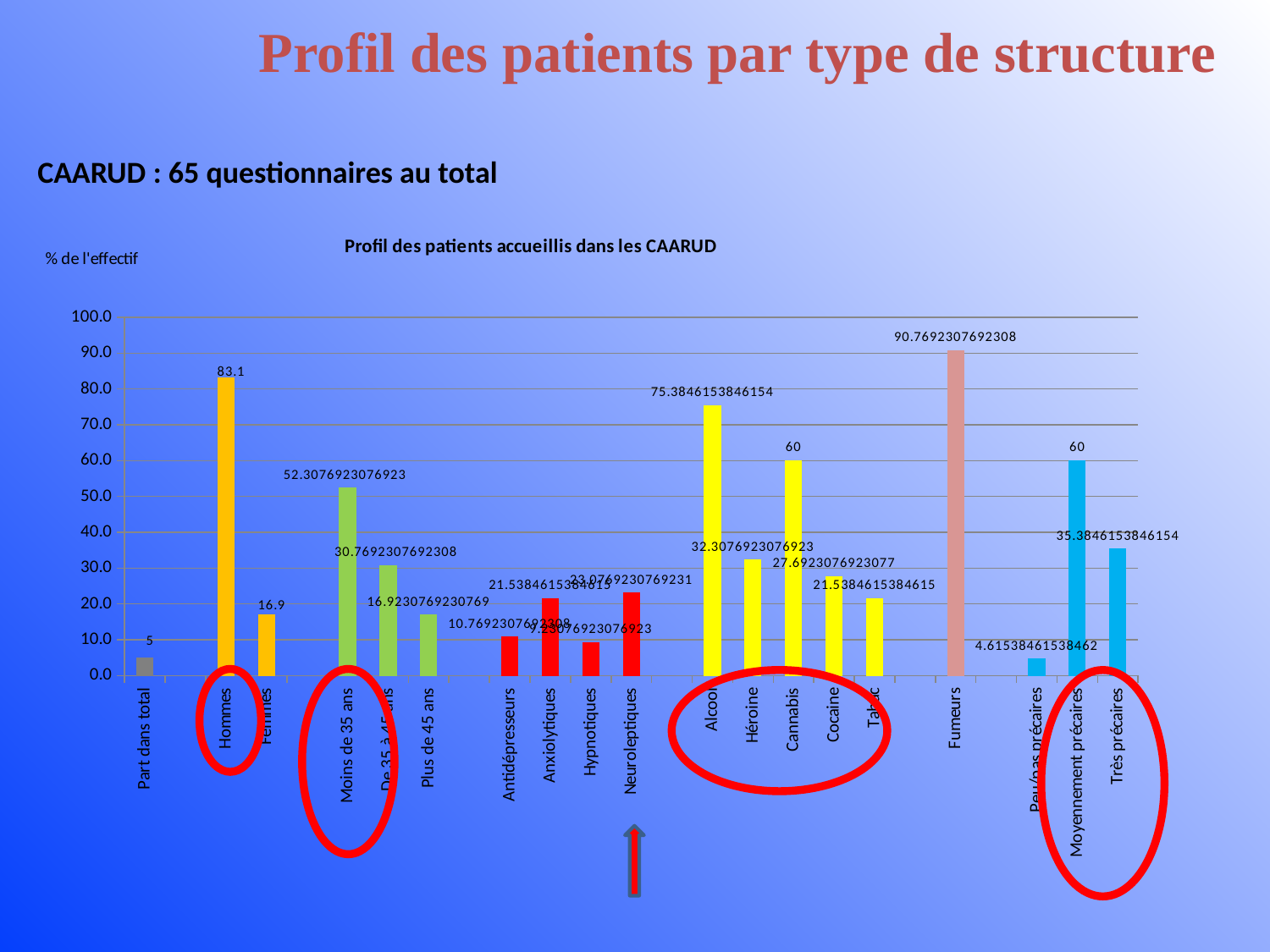
Is the value for Alcool greater or less than 70? greater Which category has the lowest value? Peu/pas précaires What is the difference between the values for Hommes and Femmes? 66.2 What is the value for Peu/pas précaires? 4.61538461538462 What is the value for Hommes? 83.1 What kind of chart is shown on the slide? Bar chart What is the value for Moins de 35 ans? 52.3076923076923 What is the value for Alcool? 75.3846153846154 What is the value for Fumeurs? 90.7692307692308 Which category has the highest value? Fumeurs What is the title of the chart? Profil des patients accueillis dans les CAARUD Which is larger, the value for Cannabis or the value for Héroine? Cannabis